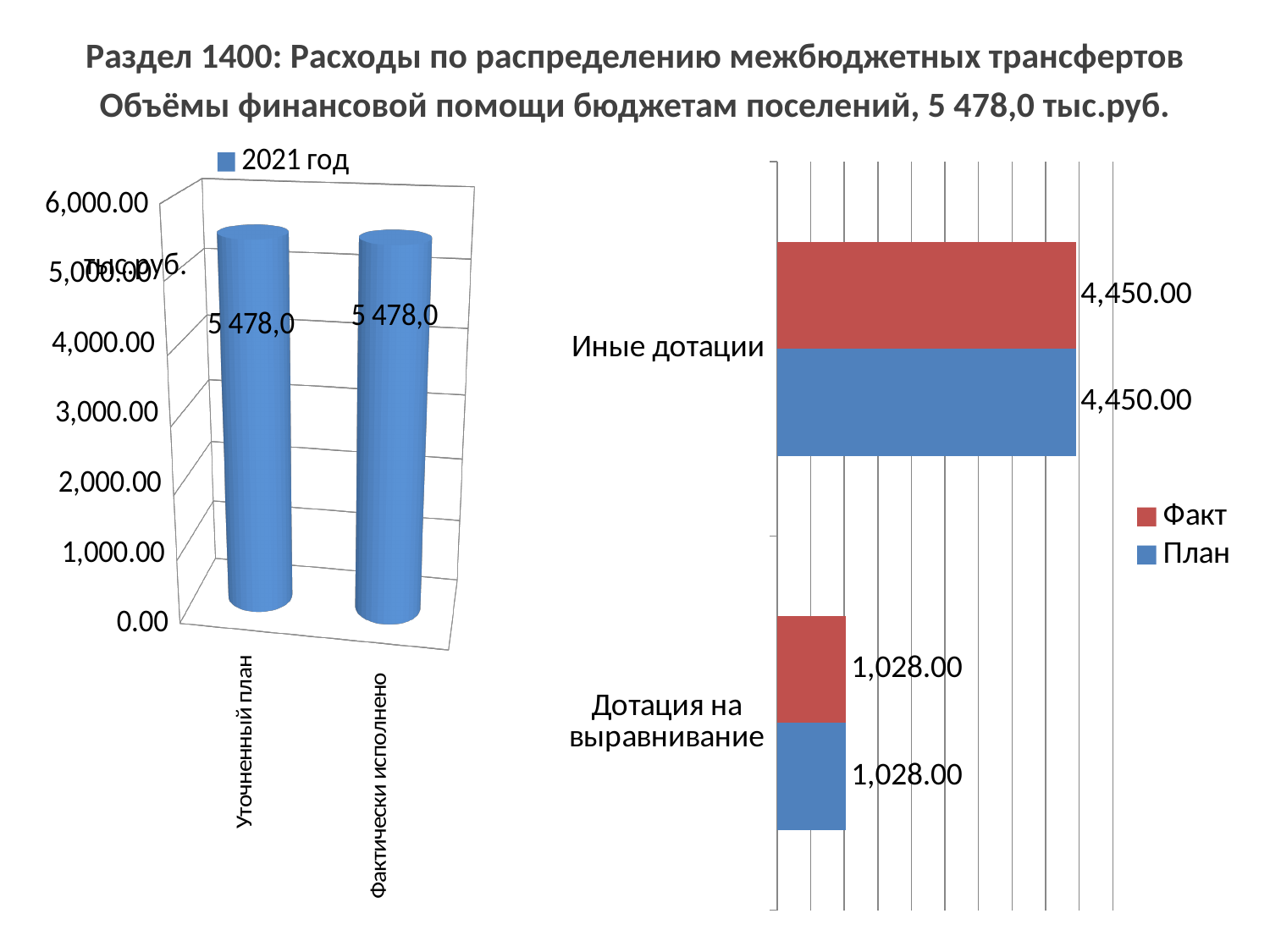
In the right chart, what is the Факт value for Дотация на выравнивание? 1,028.00 In the left chart, what is the value for Уточненный план? 5 478,0 In the left chart, how many categories are shown on the x axis? 2 In the right chart, which category has the lowest План value? Дотация на выравнивание What kind of chart is the right chart? Bar chart In the left chart, what is the value for Фактически исполнено? 5 478,0 In the right chart, what is the План value for Иные дотации? 4,450.00 In the left chart, what series does the legend list? 2021 год In the right chart, what is the difference between the Факт value for Иные дотации and the Факт value for Дотация на выравнивание? 3,422.00 In the right chart, how many series does the legend list? 2 In the left chart, is the value for Уточненный план greater or less than 5,000.00? greater In the right chart, which category has the highest Факт value? Иные дотации